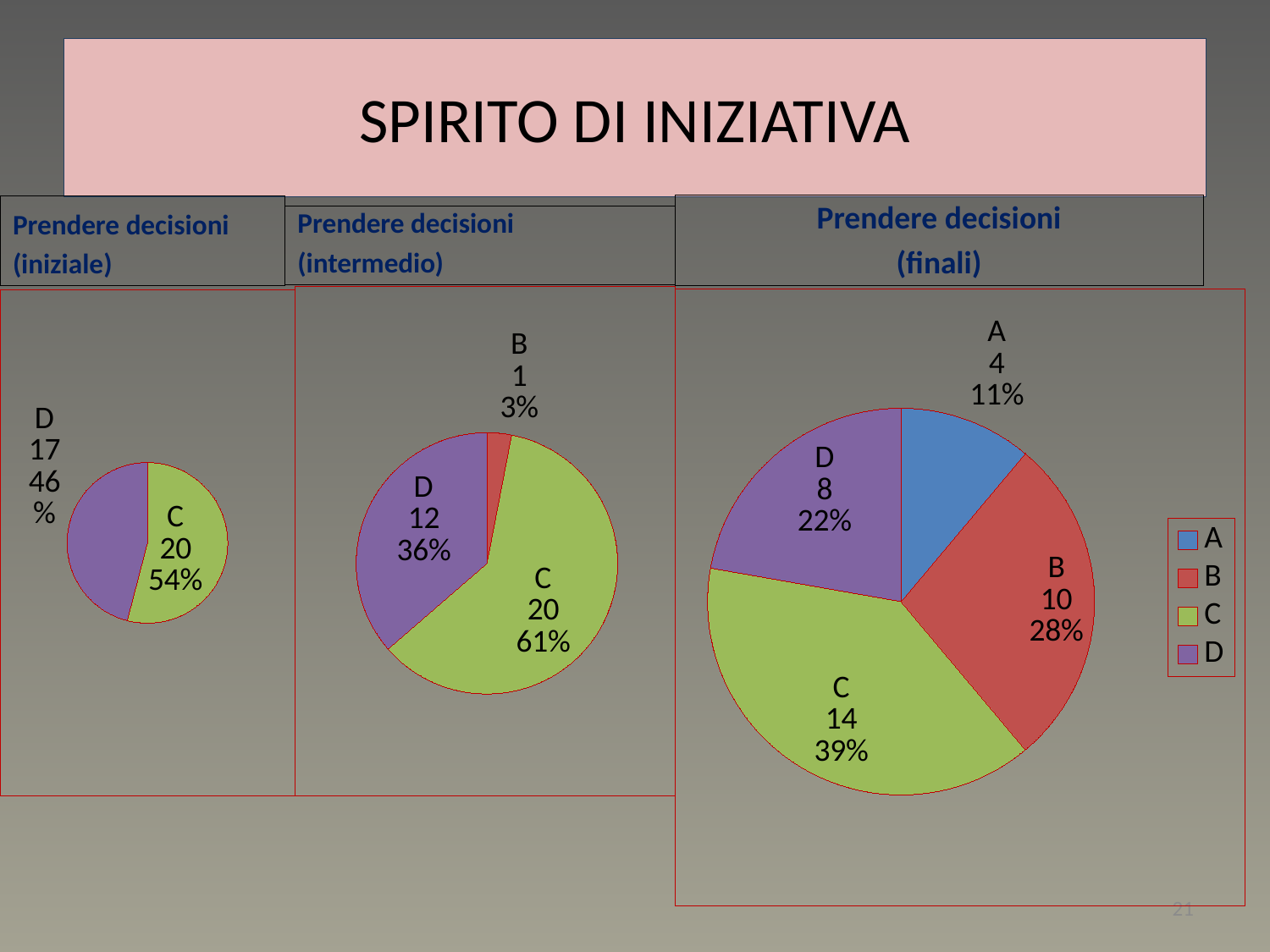
In the 'Prendere decisioni (finali)' chart, what percentage share does category B have? 28% In the 'Prendere decisioni (finali)' chart, which category has the smallest slice? A How many entries does the legend next to the 'Prendere decisioni (finali)' chart list? 4 How many slices does the 'Prendere decisioni (finali)' pie chart have? 4 In the 'Prendere decisioni (intermedio)' chart, what value is shown for category D? 12 What type of chart is used for 'Prendere decisioni (iniziale)'? Pie chart In the 'Prendere decisioni (finali)' chart, which category has the largest slice? C In the 'Prendere decisioni (intermedio)' chart, which category has the smallest slice? B In the 'Prendere decisioni (iniziale)' chart, what percentage share does category C have? 54% In the 'Prendere decisioni (finali)' chart, what is the difference between the values for B and D? 2 In the 'Prendere decisioni (finali)' chart, what value is shown for category C? 14 In the 'Prendere decisioni (intermedio)' chart, which is larger, the value for C or the value for D? C